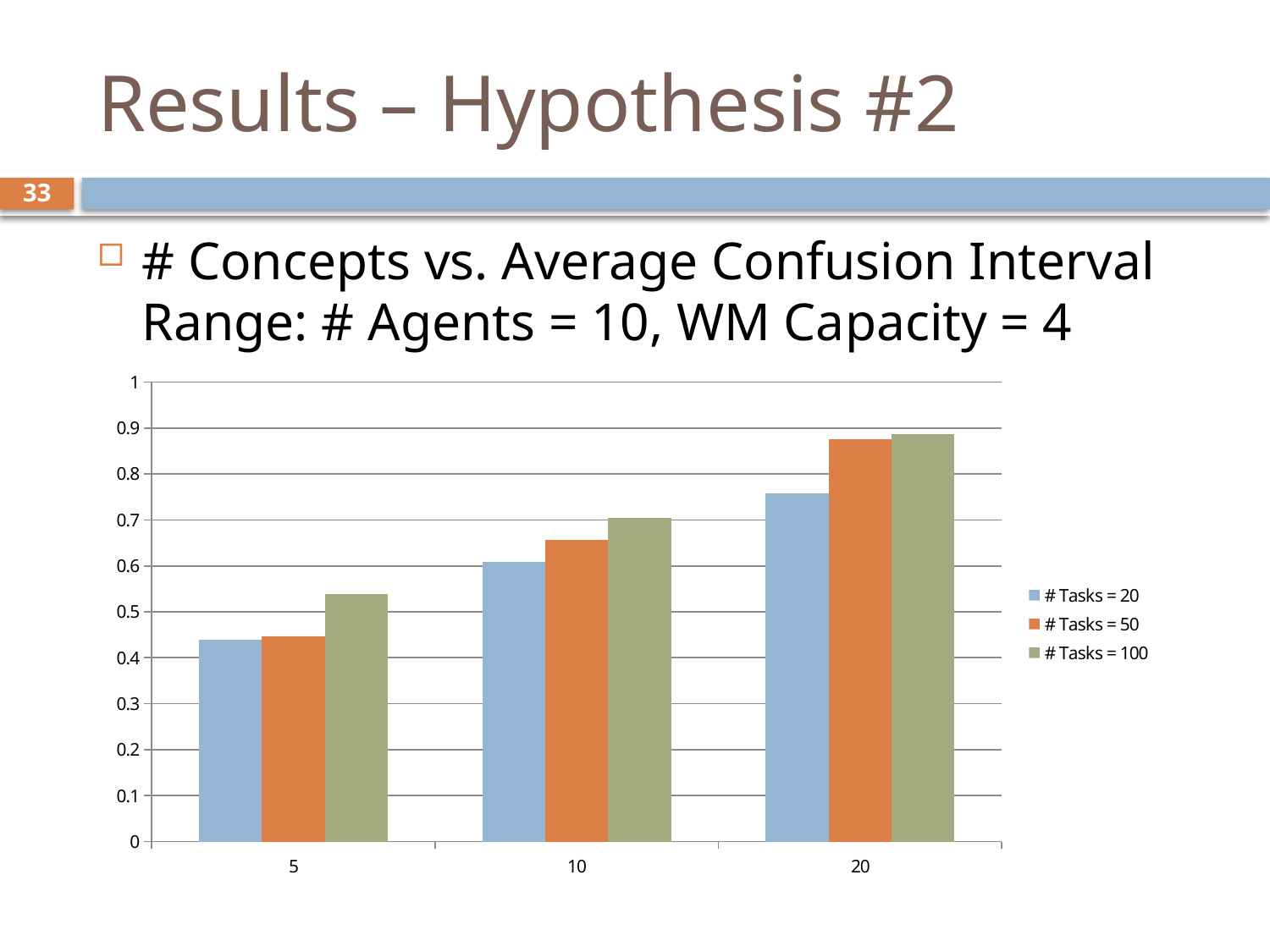
Is the value for # Tasks = 20 at category 5 greater or less than 0.5? less Is the value for # Tasks = 20 at category 10 greater or less than 0.7? less How many categories are shown on the x axis? 3 Which category has the lowest value for the # Tasks = 20 series? 5 At category 10, which is larger: the value for # Tasks = 20 or the value for # Tasks = 100? # Tasks = 100 How many series does the legend list? 3 Which category has the highest value for the # Tasks = 100 series? 20 Do the values for the # Tasks = 50 series rise or fall as the number of concepts increases along the x axis? rise Is the value for # Tasks = 50 at category 20 greater or less than 0.8? greater What kind of chart is shown on the slide? bar chart Which legend entry is shown in orange? # Tasks = 50